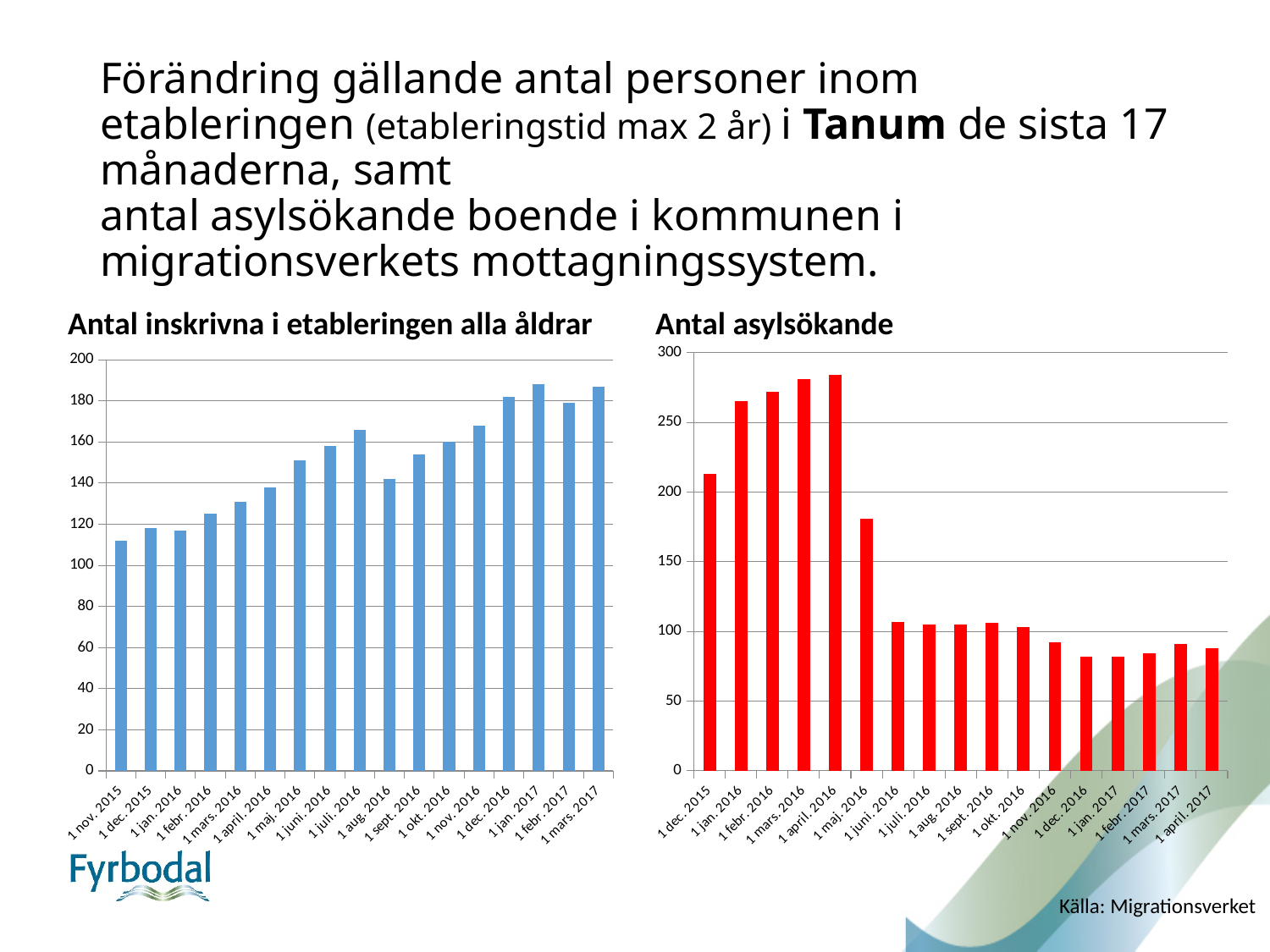
In the 'Antal asylsökande' chart, is the value for 1 maj 2016 greater or less than 200? less In the 'Antal asylsökande' chart, which is larger, the value for 1 jan. 2016 or the value for 1 maj 2016? 1 jan. 2016 In the 'Antal asylsökande' chart, do the values overall rise or fall from 1 april 2016 to 1 april 2017? fall What kind of chart is the 'Antal inskrivna i etableringen alla åldrar' chart? bar chart In the 'Antal asylsökande' chart, is the value for 1 dec. 2015 greater or less than 200? greater In the 'Antal asylsökande' chart, is the value for 1 dec. 2016 greater or less than 100? less How many bars are plotted in the 'Antal asylsökande' chart? 17 In the 'Antal inskrivna i etableringen alla åldrar' chart, which is larger, the value for 1 juli 2016 or the value for 1 aug. 2016? 1 juli 2016 How many bars are plotted in the 'Antal inskrivna i etableringen alla åldrar' chart? 17